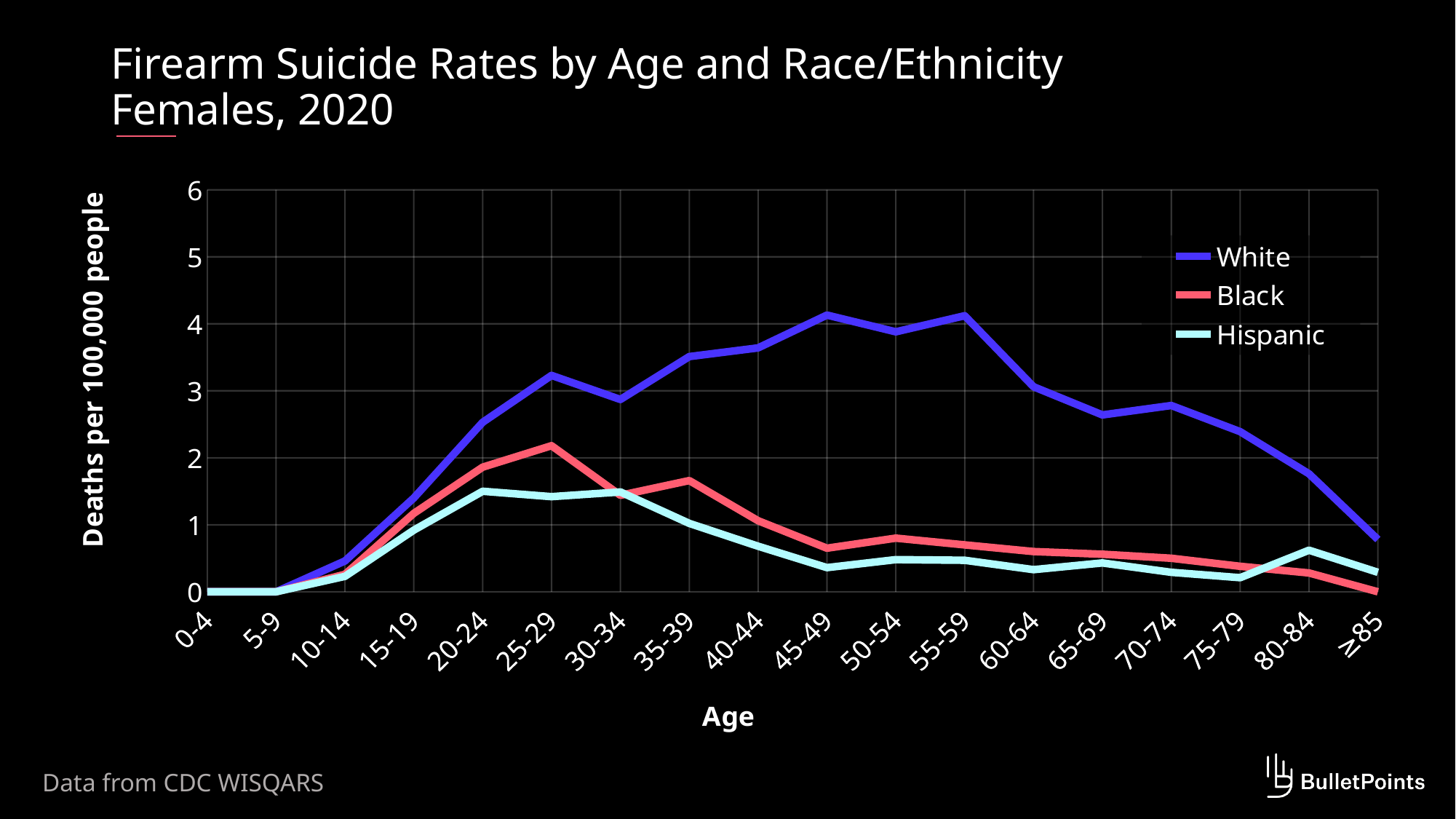
What kind of chart is shown on the slide? line chart At which age group does the Black series reach its highest value? 25-29 Is the value for Black at age 35-39 greater or less than 2? less Is the value for Hispanic at age 20-24 greater or less than 1? greater Which series has the highest value at age 50-54? White At age 35-39, which is larger, the Black value or the Hispanic value? Black Does the White series rise or fall from age 55-59 to age ≥85? fall At age 80-84, which is larger, the Hispanic value or the Black value? Hispanic How many age groups are shown on the x axis? 18 How many series does the legend list? 3 Is the value for White at age 25-29 greater or less than 3? greater